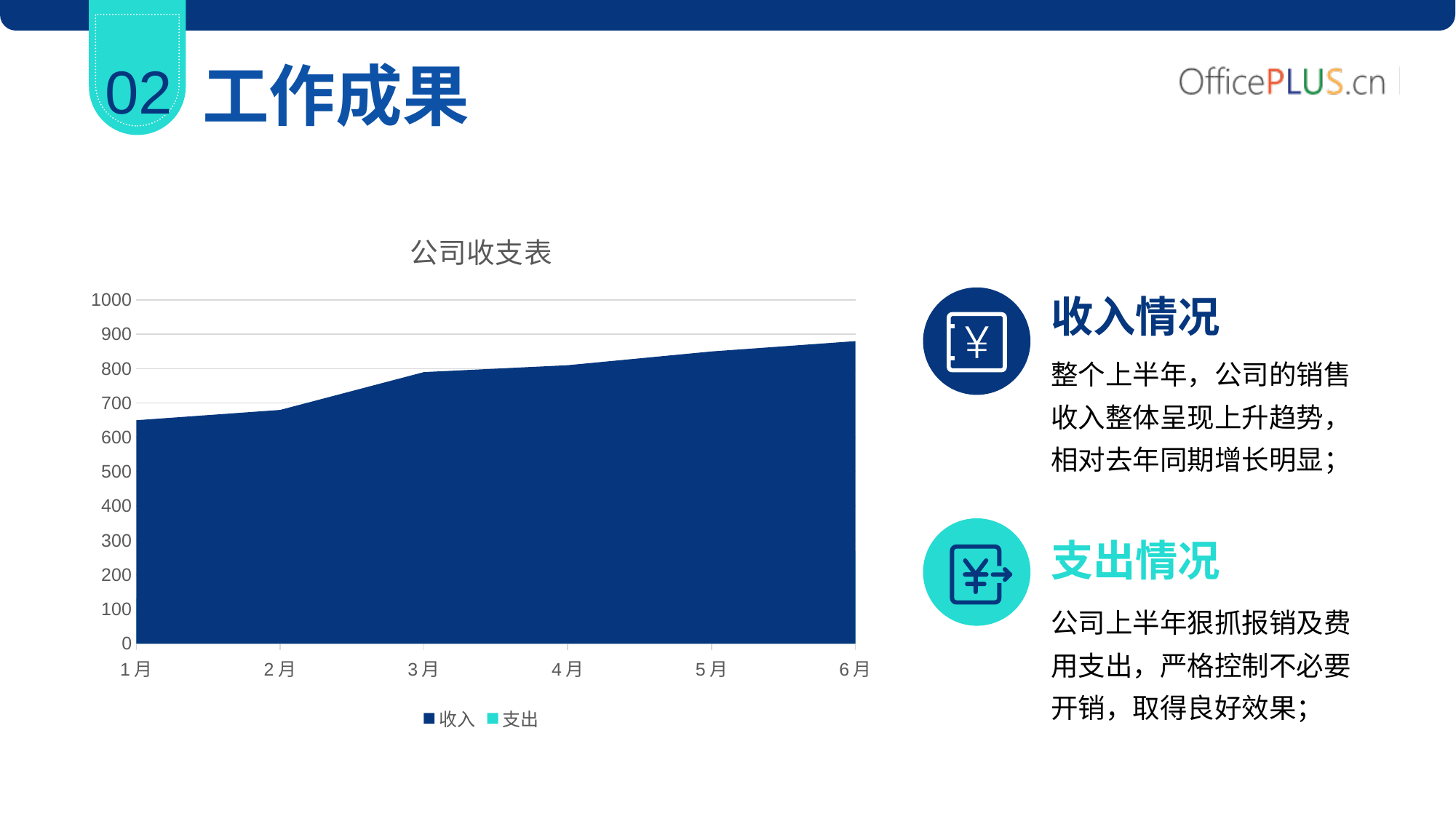
Is the 收入 value for 3月 greater or less than 700? greater What is the title of the chart? 公司收支表 Is the 收入 value for 6月 greater or less than 900? less What kind of chart is shown on the slide? Area chart Do the 收入 values rise or fall from 1月 to 6月? Rise How many series does the chart legend list? 2 Is the 收入 value for 1月 greater or less than 600? greater How many months are shown on the x axis of the chart? 6 Which month has the lowest 收入 value? 1月 Which month has the highest 收入 value? 6月 Which is larger, the 收入 value for 2月 or for 5月? 5月